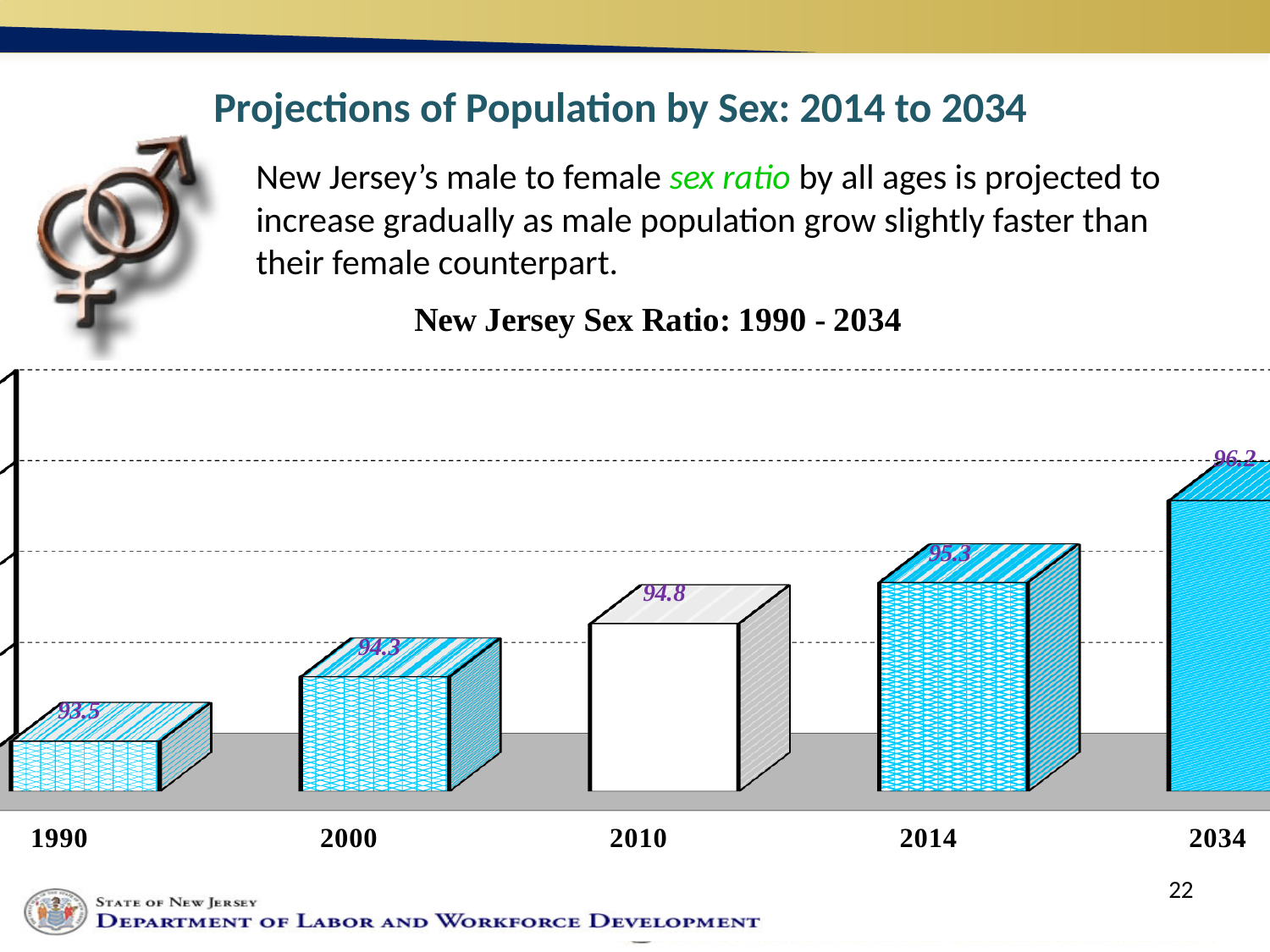
Which year has the highest sex ratio? 2034 What is the sex ratio shown for 1990? 93.5 What is the sex ratio shown for 2010? 94.8 Which year has the lowest sex ratio? 1990 What is the sex ratio shown for 2000? 94.3 What kind of chart is used to show the New Jersey sex ratio? Bar chart Do the sex ratio values rise or fall from 1990 to 2034? Rise What is the sex ratio shown for 2014? 95.3 What is the sex ratio shown for 2034? 96.2 Which is larger, the sex ratio for 2010 or for 2014? 2014 How many years are plotted on the chart? 5 What is the difference between the sex ratio in 2034 and in 1990? 2.7